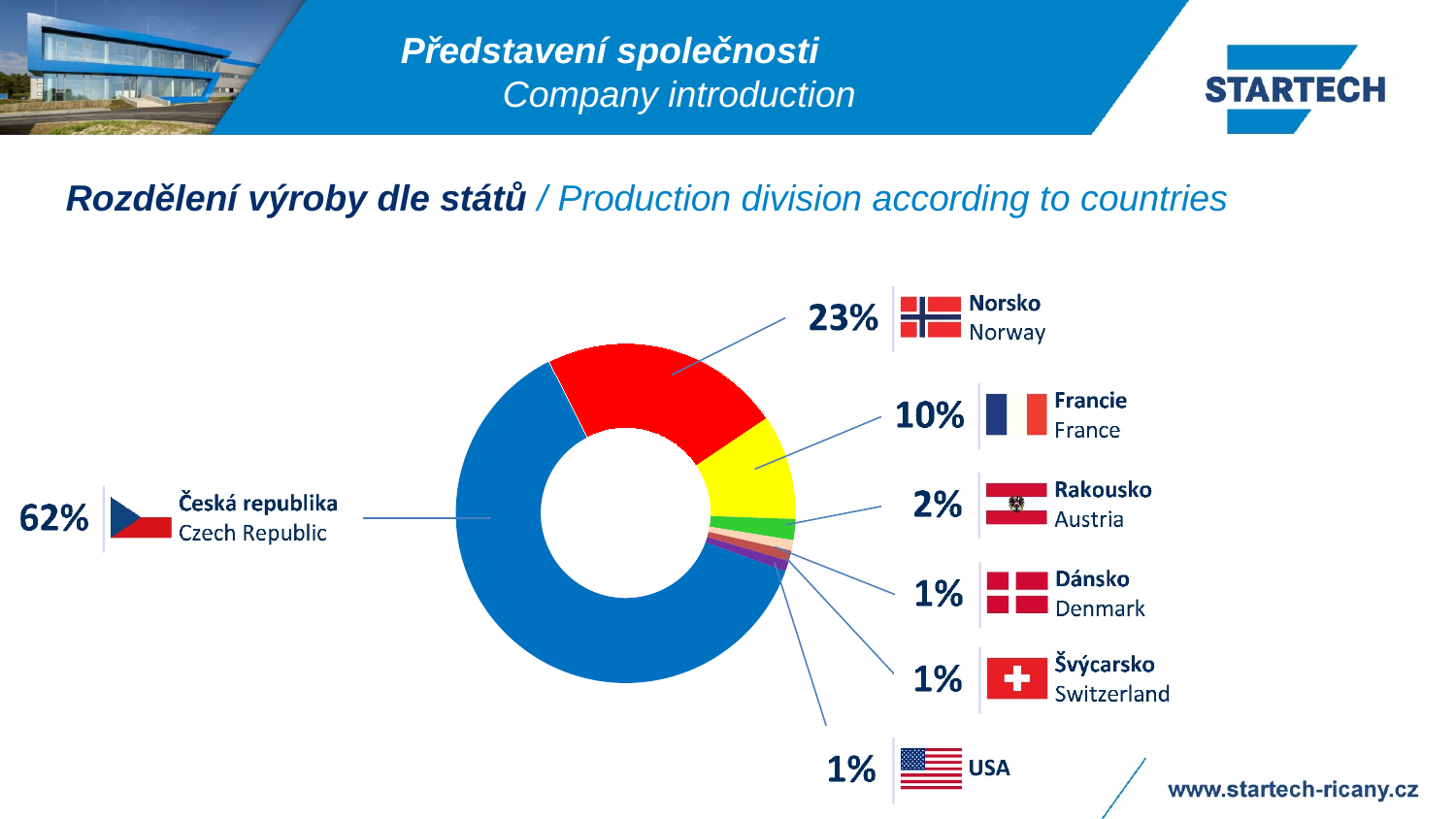
What share of production is attributed to the Czech Republic? 62% What share of production is attributed to France? 10% Which country has the largest share of production? Czech Republic What colour is the slice representing Norway? red How many countries are shown in the chart? 7 Which has a larger share of production, Norway or France? Norway What kind of chart is shown on the slide? doughnut chart What share of production is attributed to Austria? 2% What is the difference in percentage points between the Czech Republic's share and Norway's share? 39 percentage points What share of production is attributed to Norway? 23% What is the combined share of Denmark, Switzerland and the USA? 3% What share of production is attributed to the USA? 1%